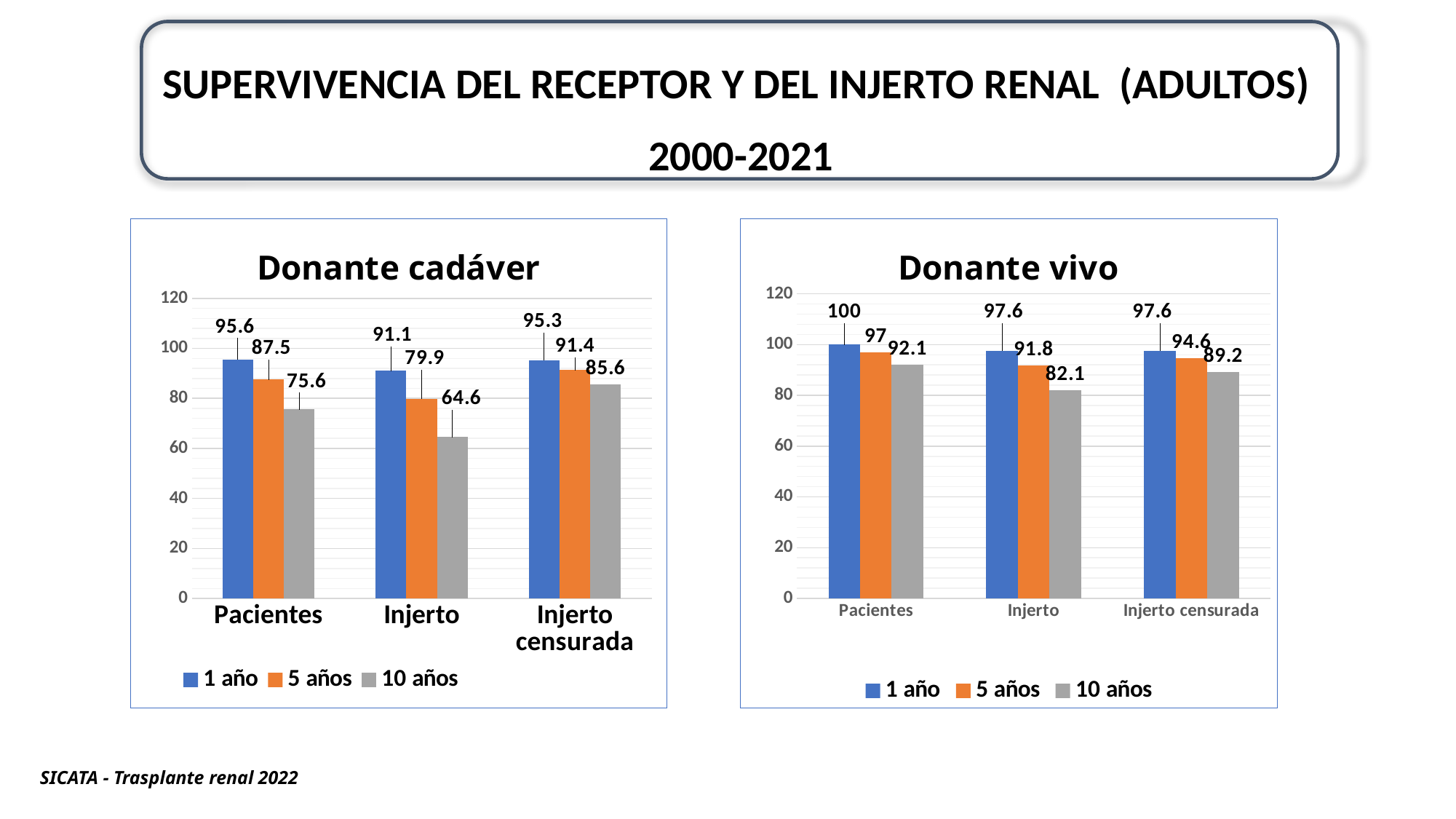
In the 'Donante cadáver' chart, what is the value for Pacientes at 1 año? 95.6 In the 'Donante cadáver' chart, which category has the lowest 10 años value? Injerto How many series does the legend of the 'Donante vivo' chart list? 3 In the 'Donante cadáver' chart, what is the difference between the 1 año and 10 años values for Injerto? 26.5 In the 'Donante cadáver' chart, what is the value for Injerto at 10 años? 64.6 Which is larger: the 10 años value for Injerto censurada in the 'Donante cadáver' chart or in the 'Donante vivo' chart? Donante vivo In the 'Donante vivo' chart, which category has the highest 10 años value? Pacientes In the 'Donante vivo' chart, what is the value for Injerto censurada at 5 años? 94.6 In the 'Donante vivo' chart, what is the difference between the 5 años values for Pacientes and Injerto? 5.2 In the 'Donante vivo' chart, what is the value for Pacientes at 1 año? 100 What kind of chart is the 'Donante cadáver' chart? Bar chart How many categories are shown on the x axis of the 'Donante cadáver' chart? 3